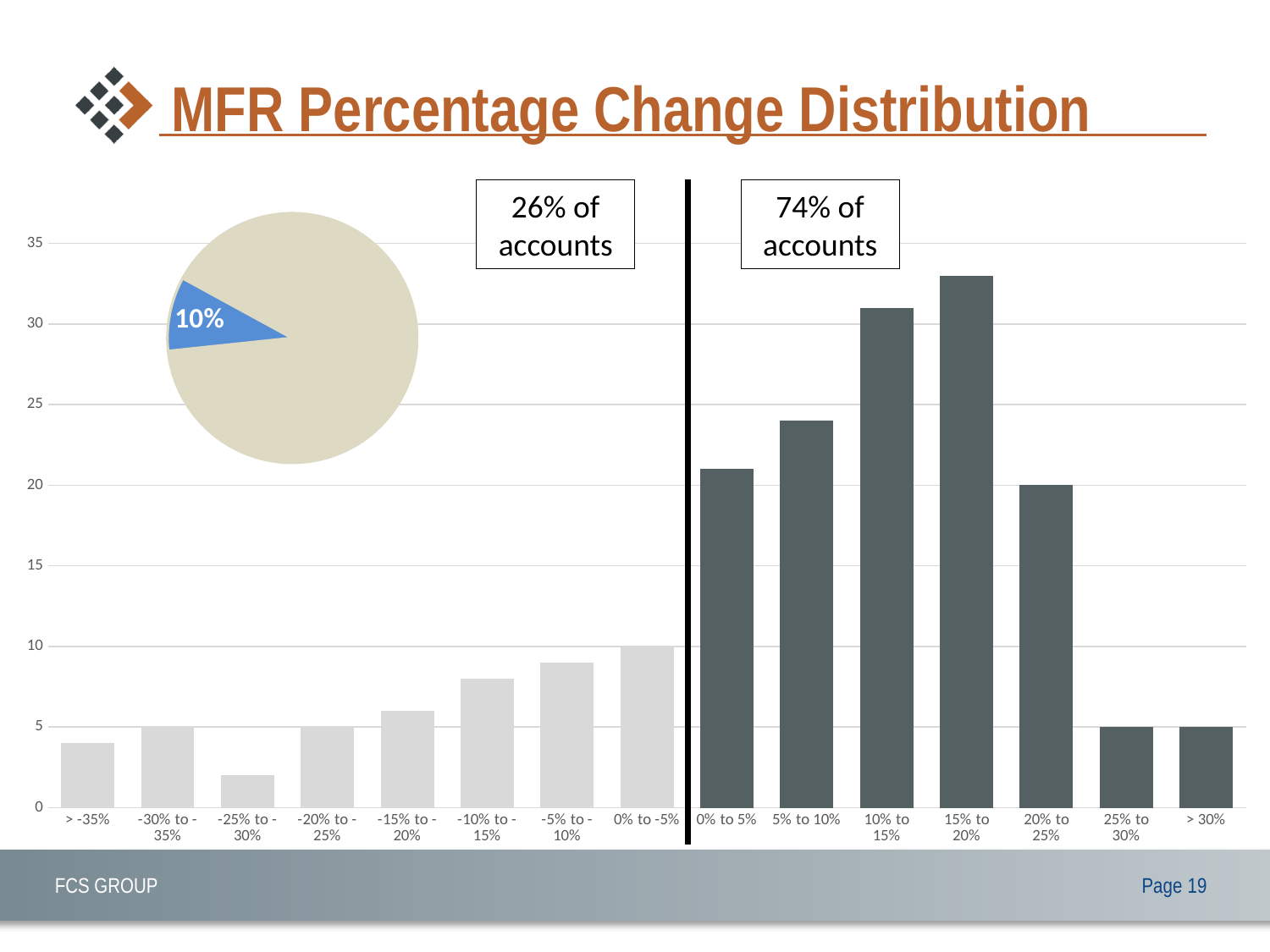
In the bar chart, is the value for 10% to 15% greater or less than 30? greater What kind of chart is the large chart on the slide? bar chart In the bar chart, which category has the highest bar? 15% to 20% According to the text box on the right side of the bar chart, what share of accounts falls in the positive-change categories? 74% of accounts How many categories are shown on the x axis of the bar chart? 15 In the bar chart, is the value for 0% to 5% greater or less than 20? greater In the bar chart, what is the value for the 0% to -5% category? 10 In the bar chart, which is larger, the value for 10% to 15% or the value for 20% to 25%? 10% to 15% In the bar chart, which category has the lowest bar? -25% to -30% In the bar chart, what is the value for the 20% to 25% category? 20 What percentage is labelled on the blue slice of the pie chart? 10% In the bar chart, is the value for 5% to 10% greater or less than 25? less